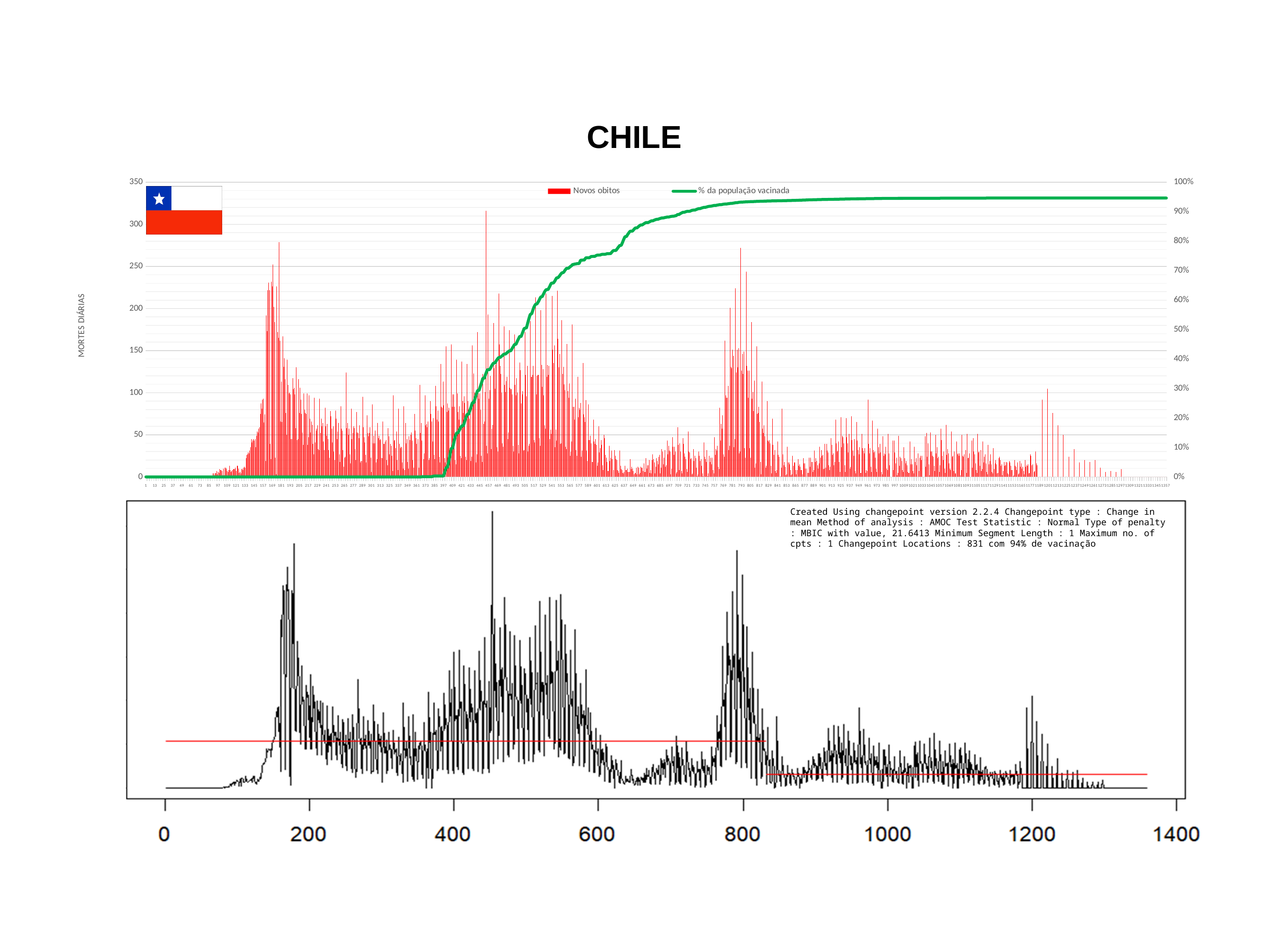
In the bottom chart, at what location does the text say the changepoint occurs? 831 In the top chart, what kind of chart is used to show Novos obitos? bar chart In the top chart, does the % da população vacinada line rise or fall along the x axis? rise In the bottom chart, how many tick labels are shown on the x axis? 8 In the top chart, what colour is the % da população vacinada line? green In the top chart, how many series does the legend list? 2 In the top chart, is the final value of % da população vacinada greater or less than 90%? greater In the top chart, is the value of % da população vacinada at x = 1 greater or less than 10%? less In the bottom chart, what vaccination percentage does the text associate with the changepoint? 94% In the top chart, what is the label of the left vertical axis? MORTES DIÁRIAS In the bottom chart, how many red horizontal mean segments are drawn? 2 In the top chart, is the tallest Novos obitos bar greater or less than 250? greater